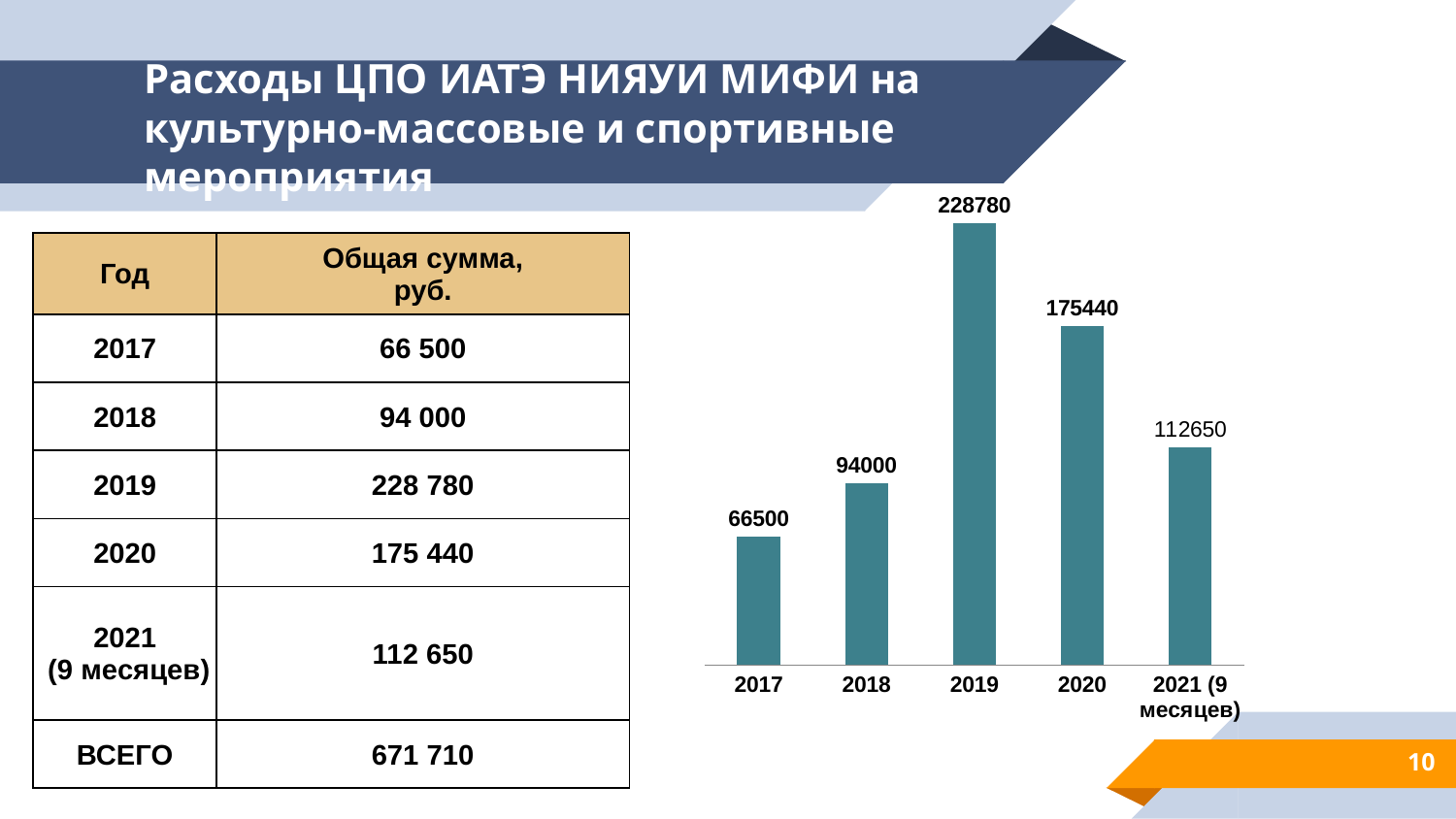
What is the difference between the values for 2019 and 2020 in the chart? 53340 Do the values in the chart rise or fall from 2017 to 2019? rise What type of chart is shown on the slide? bar chart Which is larger in the chart, the value for 2018 or the value for 2021 (9 месяцев)? 2021 (9 месяцев) What is the value shown for 2019 in the chart? 228780 What is the value shown for 2017 in the chart? 66500 Which year has the lowest value in the chart? 2017 Which year has the highest value in the chart? 2019 How many bars (categories) does the chart show? 5 What is the value shown for 2020 in the chart? 175440 What is the value shown for 2018 in the chart? 94000 What is the value shown for 2021 (9 месяцев) in the chart? 112650